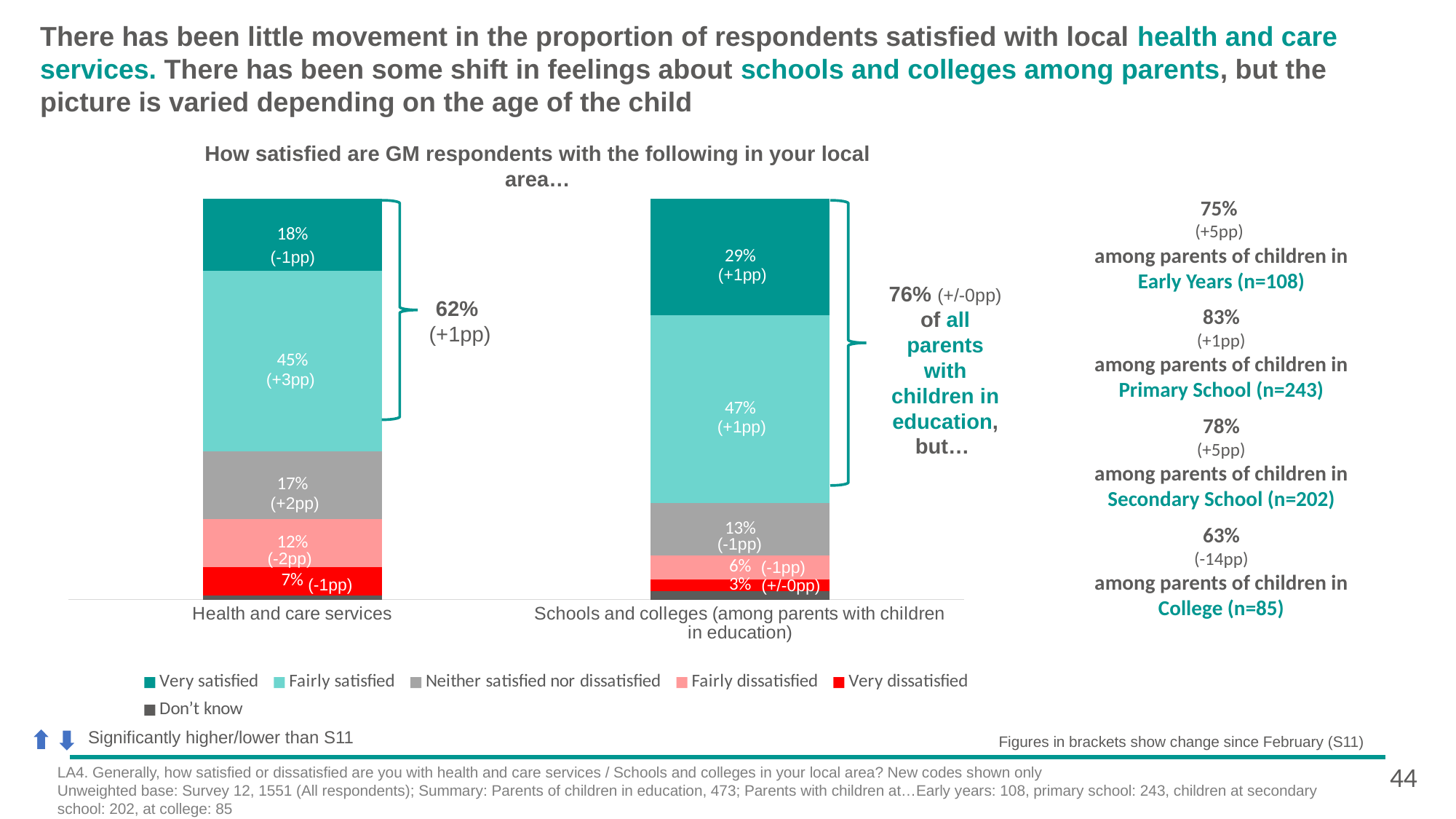
What is the 'Neither satisfied nor dissatisfied' value for Schools and colleges? 13% How many categories (bars) are plotted in the chart? 2 How many series does the legend list? 6 What is the 'Very satisfied' value for Health and care services? 18% Which segment is the largest in the Health and care services bar? Fairly satisfied What is the change since February shown in brackets for the 'Fairly satisfied' segment of Health and care services? +3pp Which category has the higher 'Very satisfied' value, Health and care services or Schools and colleges? Schools and colleges What is the difference between the 'Fairly dissatisfied' values for Health and care services (12%) and Schools and colleges (6%)? 6 percentage points What combined satisfied percentage is shown by the bracket next to the Health and care services bar? 62% What is the 'Very dissatisfied' value for Health and care services? 7% What kind of chart is shown on the slide? Stacked bar chart What is the 'Fairly satisfied' value for Schools and colleges (among parents with children in education)? 47%